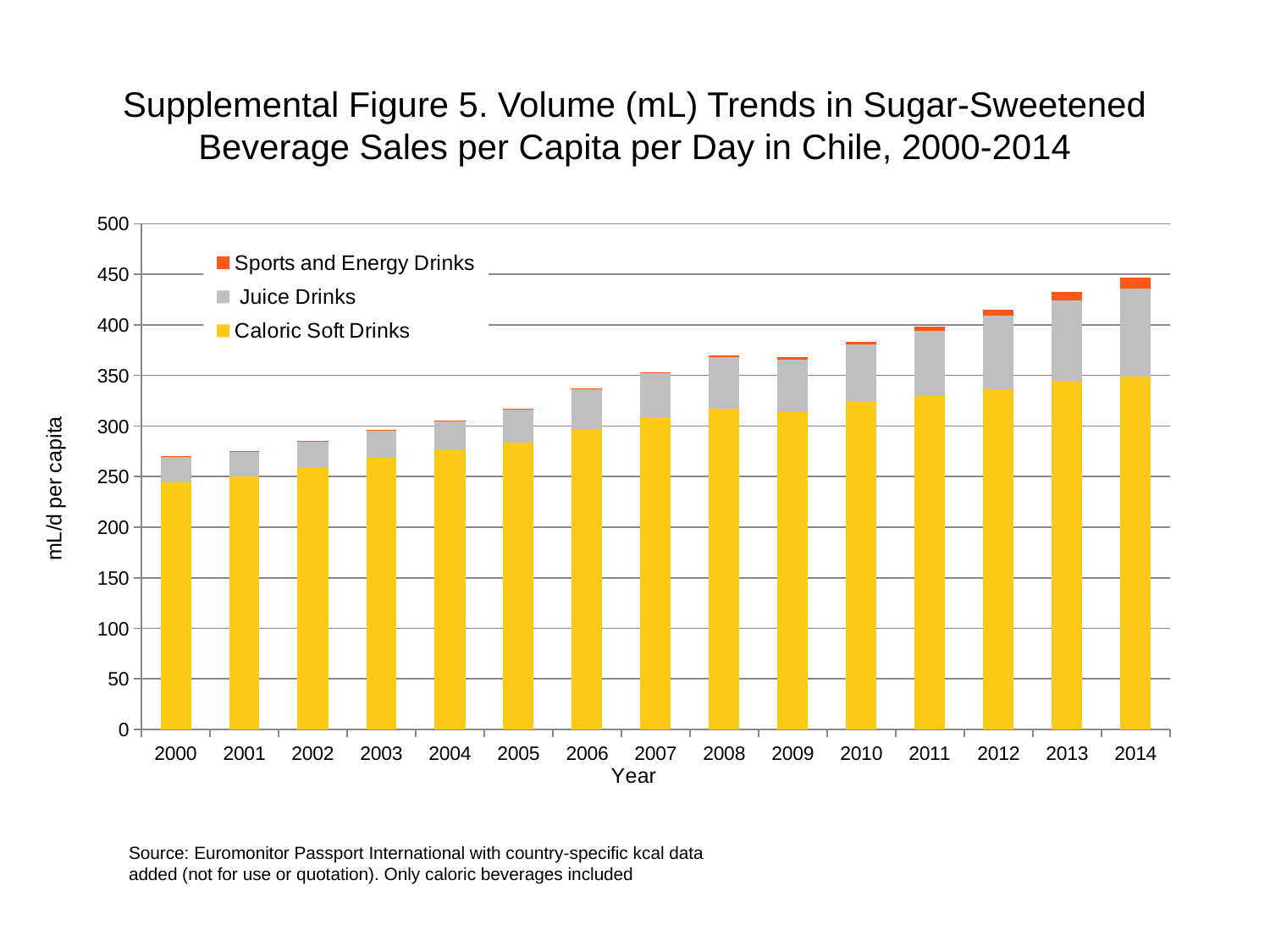
How many years are shown along the x axis? 15 Which year has the larger total bar, 2005 or 2010? 2010 What kind of chart is shown on the slide? Stacked bar chart Do the total bar heights generally rise or fall from 2000 to 2014? Rise Which year has the tallest total bar? 2014 Is the total bar height for 2000 greater or less than 300? less What is the label on the y axis? mL/d per capita Is the Caloric Soft Drinks value for 2014 greater or less than 300? greater Is the total bar height for 2014 greater or less than 400? greater How many series does the legend list? 3 Which year has the shortest total bar? 2000